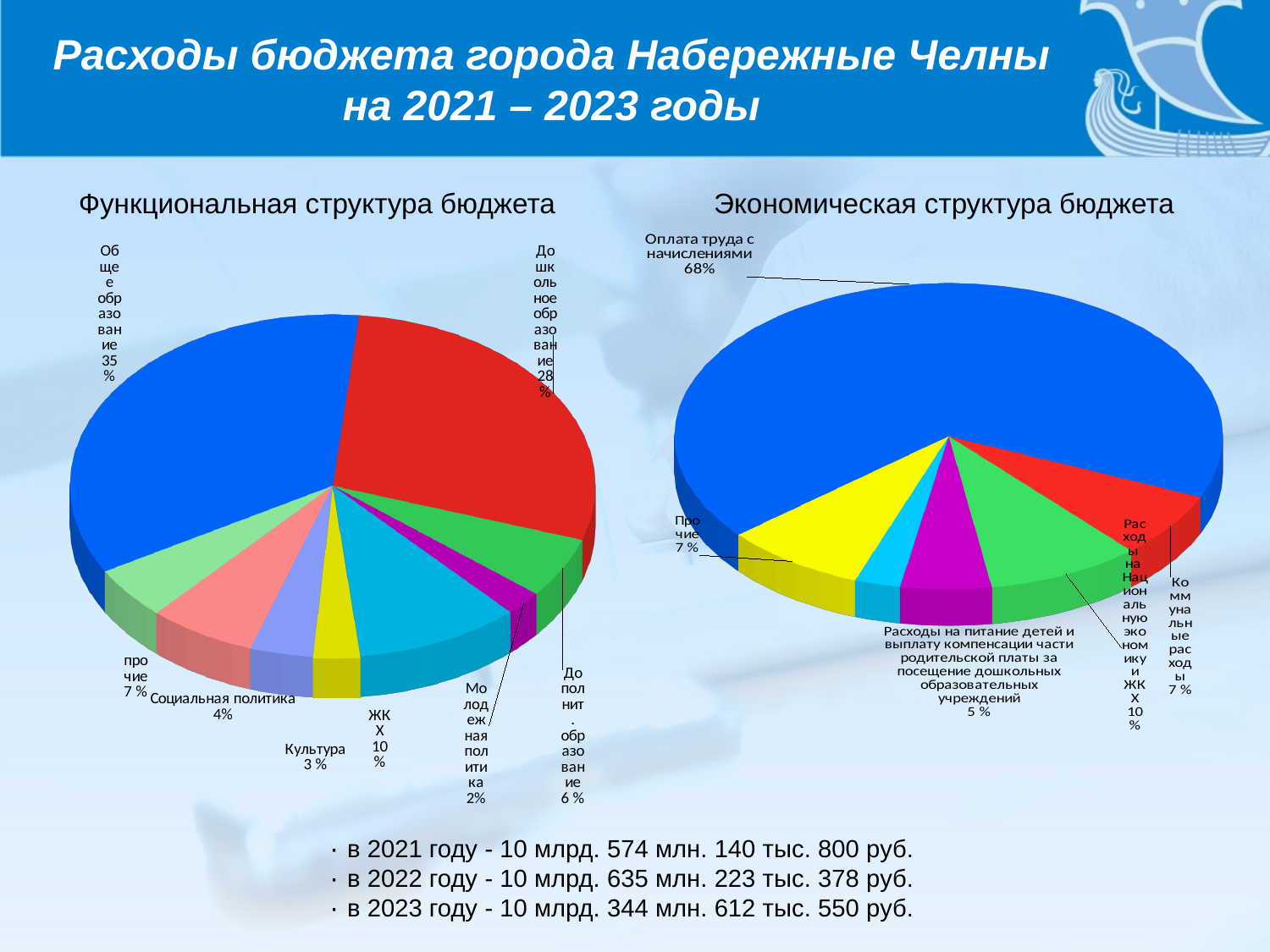
On the right chart 'Экономическая структура бюджета', what share is shown for Оплата труда с начислениями? 68% On the left chart 'Функциональная структура бюджета', what share is shown for Культура? 3 % On the left chart 'Функциональная структура бюджета', what is the difference in percentage points between Общее образование and Дошкольное образование? 7 On the right chart 'Экономическая структура бюджета', which is larger: Коммунальные расходы or Расходы на питание детей и выплату компенсации части родительской платы за посещение дошкольных образовательных учреждений? Коммунальные расходы On the left chart 'Функциональная структура бюджета', what share is shown for Общее образование? 35% What kind of chart is used for 'Экономическая структура бюджета' on the right? Pie chart On the left chart 'Функциональная структура бюджета', what share is shown for Дошкольное образование? 28% On the left chart 'Функциональная структура бюджета', which labelled category has the largest share? Общее образование What is the title of the chart on the left side of the slide? Функциональная структура бюджета On the left chart 'Функциональная структура бюджета', what share is shown for ЖКХ? 10% On the right chart 'Экономическая структура бюджета', what share is shown for Расходы на Национальную экономику и ЖКХ? 10 % On the left chart 'Функциональная структура бюджета', which labelled category has the smallest share? Молодежная политика